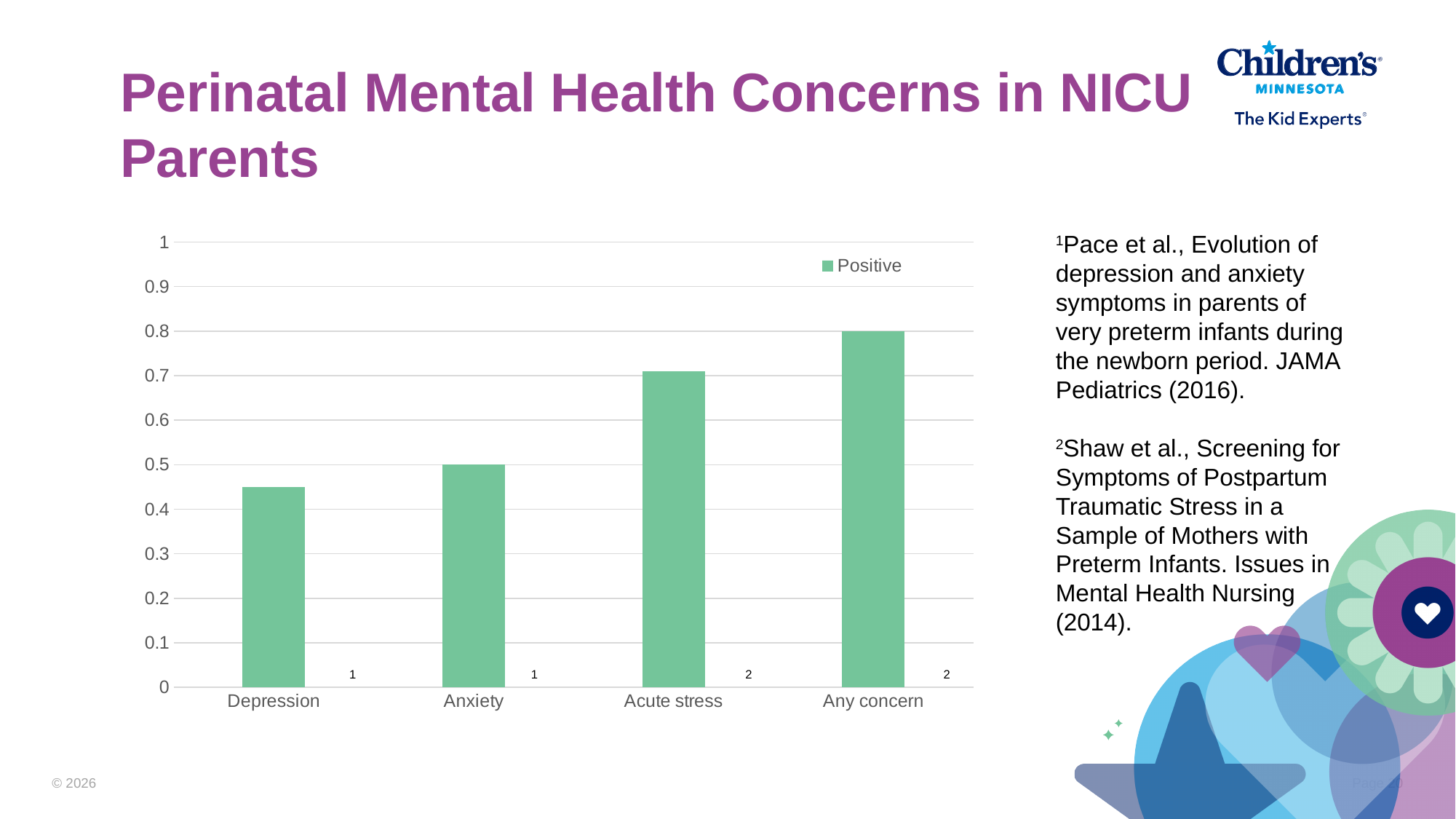
Is the value for Depression greater or less than 0.4? greater What kind of chart is shown on the slide? bar chart Is the value for Depression greater or less than 0.5? less Is the value for Acute stress greater or less than 0.8? less Which category has the lowest value in the chart? Depression Which category has the highest value in the chart? Any concern How many series does the chart legend list? 1 Which is larger, the value for Acute stress or the value for Anxiety? Acute stress How many categories are shown on the x axis of the chart? 4 Do the values rise or fall moving from Depression to Any concern along the x axis? rise What is the name of the series listed in the chart legend? Positive